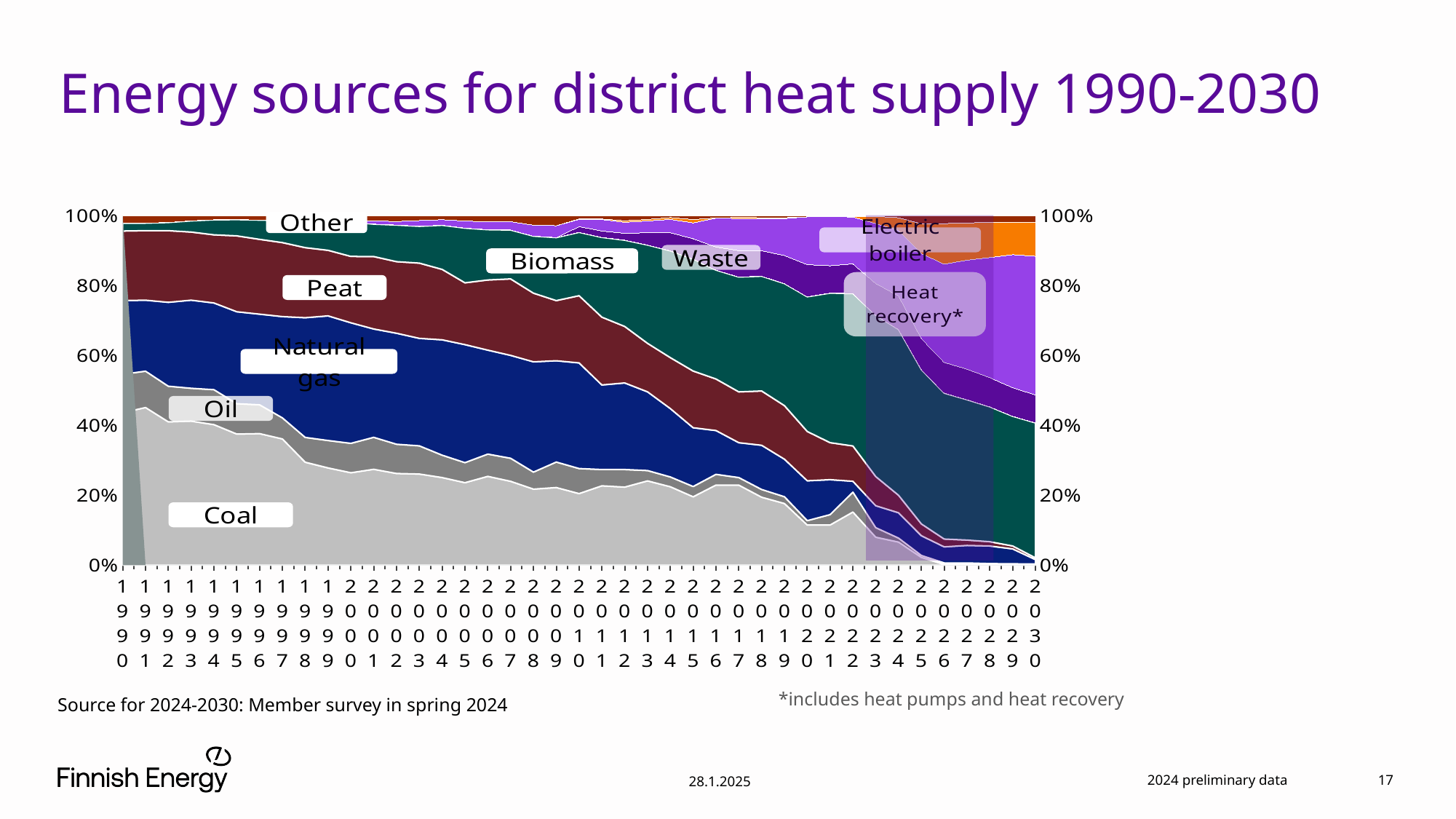
What is the last year shown on the x axis? 2030 Is the share of coal in 1990 greater or less than 20%? greater What kind of chart is shown on the slide? Stacked area chart How many energy sources are labelled in the chart? 9 Is the share of coal in 2010 greater or less than 40%? less Does the share of coal rise or fall from 1990 to 2030? Fall In 1990, which has the larger share, coal or oil? Coal Which energy source has the largest share in 1990? Coal What is the first year shown on the x axis? 1990 How many years are shown along the x axis of the chart? 41 What is the title of the chart? Energy sources for district heat supply 1990-2030 Does the share of biomass rise or fall from 1990 to 2030? Rise